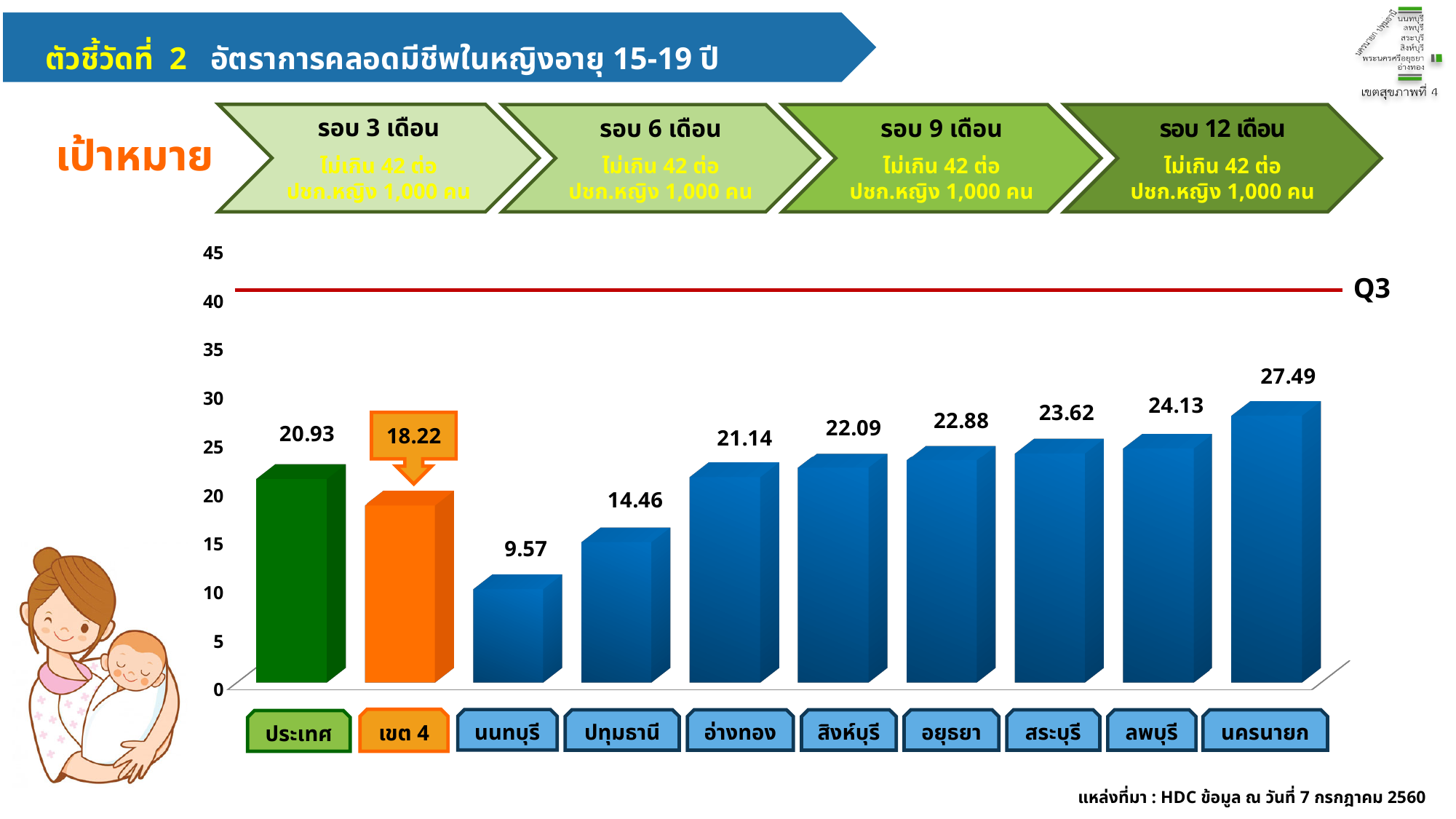
Which category has the lowest value in the chart? นนทบุรี What kind of chart is shown on the slide? bar chart Is the value for ปทุมธานี greater or less than 15? less Which category has the highest value in the chart? นครนายก How many categories (bars) are shown in the chart? 10 Which is larger, the value for ลพบุรี or the value for สระบุรี? ลพบุรี What is the value shown for นนทบุรี? 9.57 What label is attached to the red horizontal line across the chart? Q3 What is the difference between the values for ประเทศ and เขต 4? 2.71 What is the difference between the values for นครนายก and นนทบุรี? 17.92 What is the value shown for เขต 4? 18.22 What is the value shown for ประเทศ? 20.93